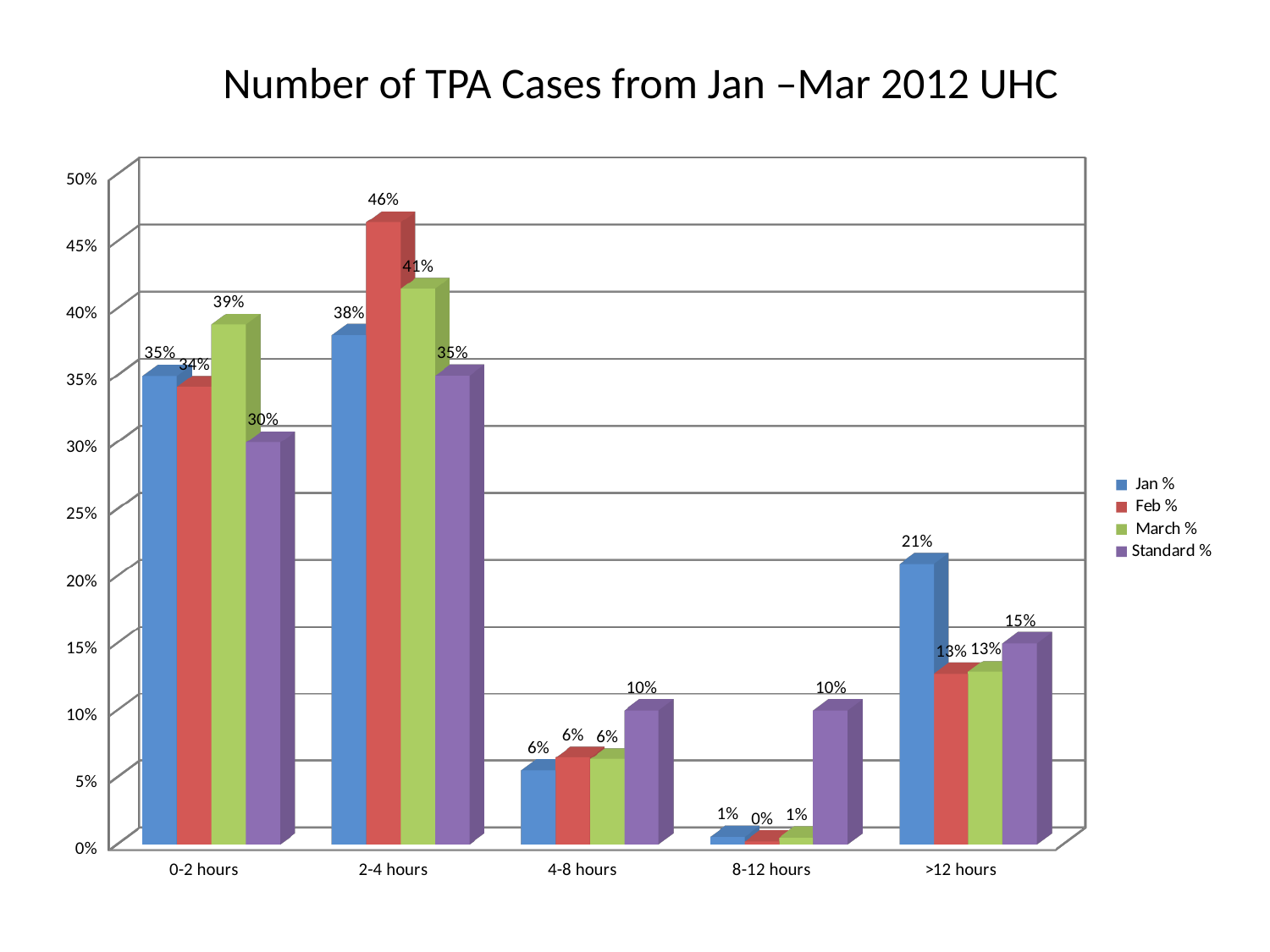
What is the difference between the Feb % and Jan % values for the 2-4 hours category? 8% What is the Jan % value for the >12 hours category? 21% Which category has the lowest Standard % value? 4-8 hours and 8-12 hours (both 10%) What is the Standard % value for the 8-12 hours category? 10% What kind of chart is shown on the slide? Bar chart How many series does the legend list? 4 Which is larger for the 0-2 hours category, the Jan % value or the Standard % value? Jan % Which category has the highest Feb % value? 2-4 hours How many time categories are shown on the x axis? 5 What is the Feb % value for the 2-4 hours category? 46% What is the March % value for the 0-2 hours category? 39% What is the title of the chart? Number of TPA Cases from Jan –Mar 2012 UHC